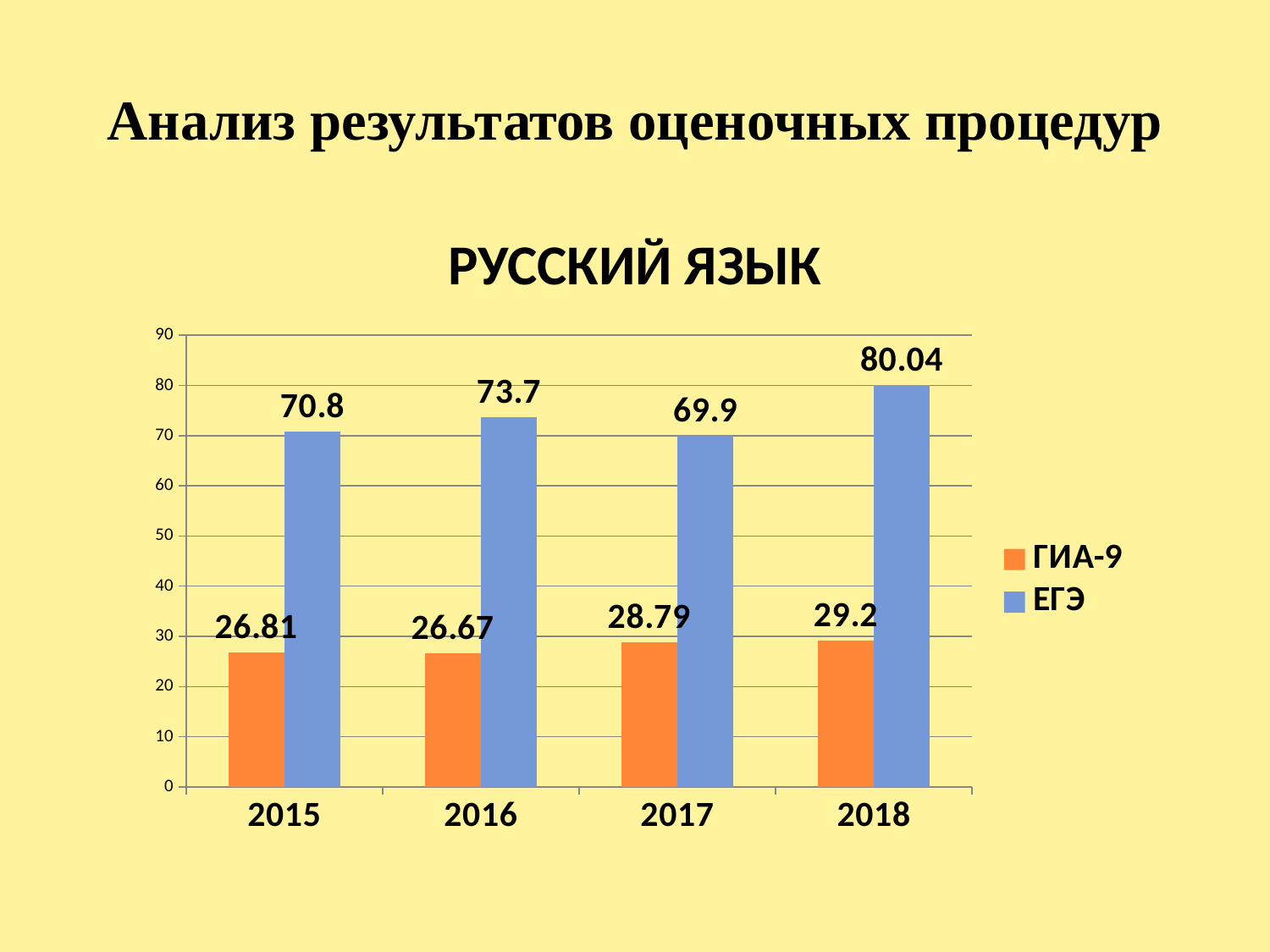
What is the ГИА-9 value for 2016? 26.67 What is the title of the chart? РУССКИЙ ЯЗЫК How many years are shown on the x axis? 4 Do the ГИА-9 values rise or fall from 2016 to 2018? rise Which is larger, the ЕГЭ value for 2016 or for 2015? 2016 What kind of chart is shown? bar chart What is the ЕГЭ value for 2018? 80.04 Which year has the highest ЕГЭ value? 2018 How many series does the legend list? 2 Which year has the lowest ГИА-9 value? 2016 What is the difference between the ЕГЭ values for 2018 and 2017? 10.14 What is the ЕГЭ value for 2017? 69.9